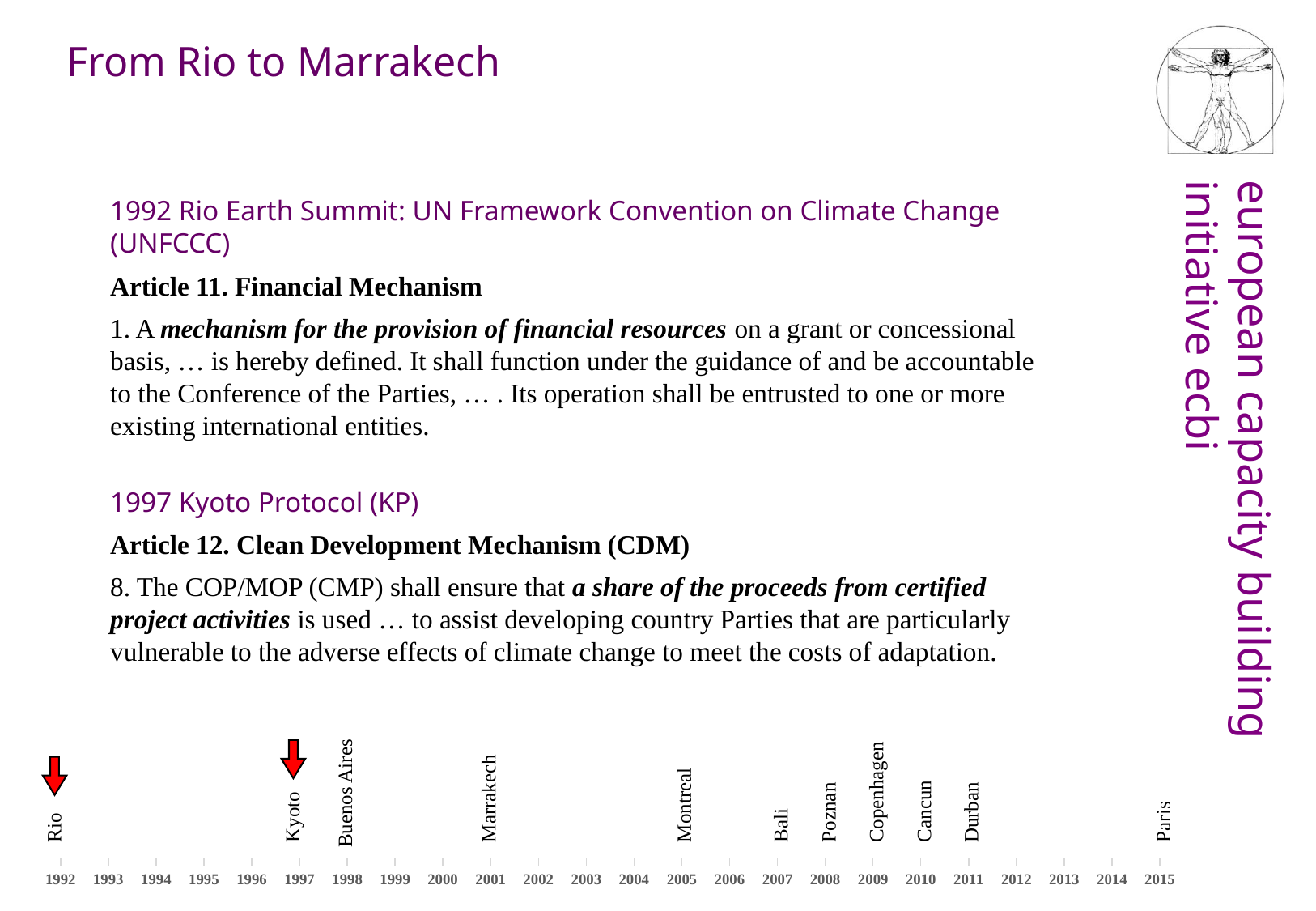
On the timeline at the bottom of the slide, which event comes earlier, Bali or Poznan? Bali On the timeline at the bottom of the slide, which year is Copenhagen placed at? 2009 On the timeline at the bottom of the slide, which event label is placed at 2005? Montreal On the timeline at the bottom of the slide, which year is Marrakech placed at? 2001 On the timeline at the bottom of the slide, which two events are marked with red arrows? Rio and Kyoto On the timeline at the bottom of the slide, which year is Paris placed at? 2015 On the timeline at the bottom of the slide, how many labelled events are shown? 11 On the timeline at the bottom of the slide, what is the first year shown on the axis? 1992 On the timeline at the bottom of the slide, which year is Kyoto placed at? 1997 On the timeline at the bottom of the slide, what is the last year shown on the axis? 2015 On the timeline at the bottom of the slide, which event label is placed at 2011? Durban On the timeline at the bottom of the slide, how many years separate Rio and Kyoto? 5